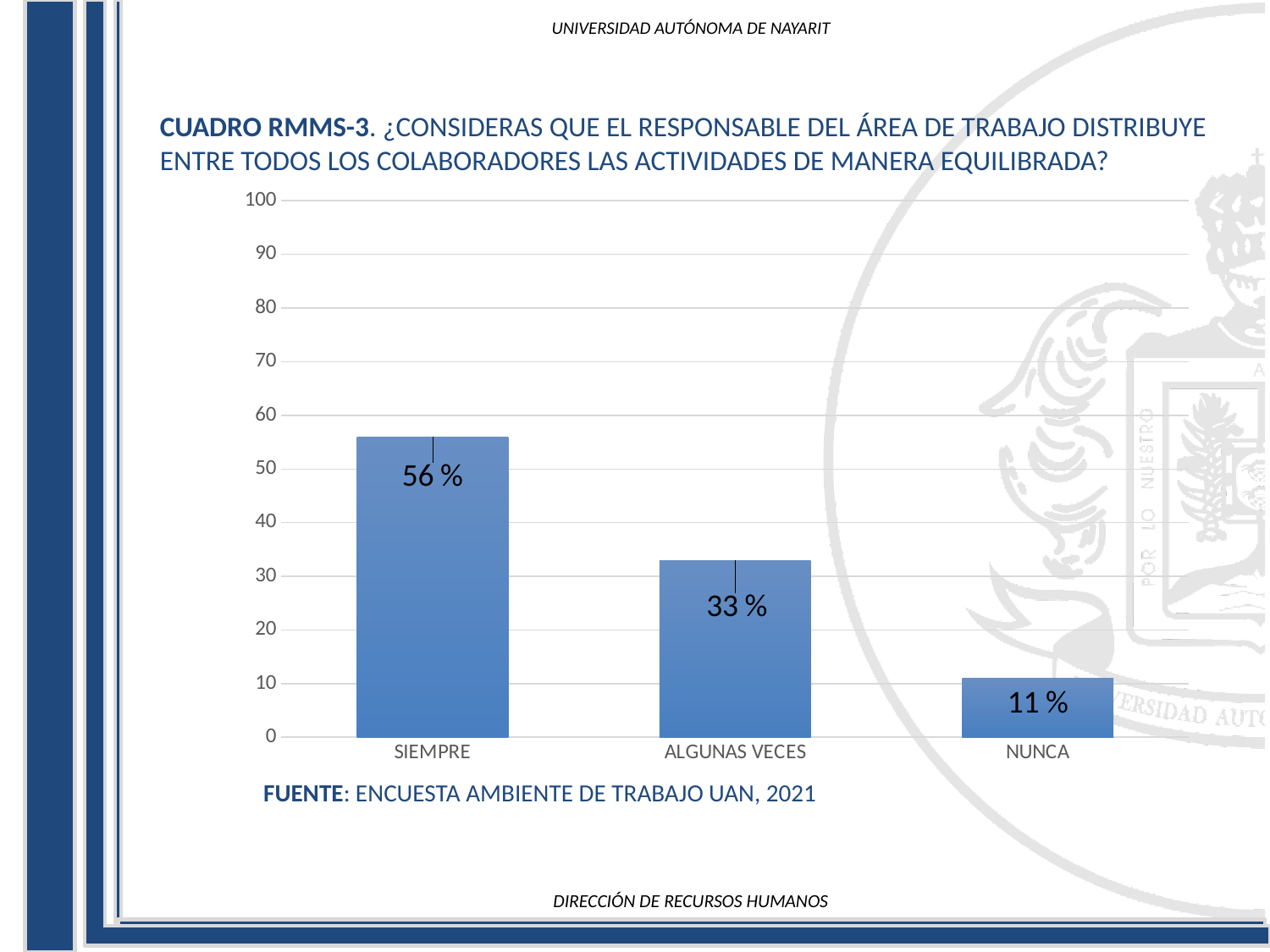
Which category has the highest value? SIEMPRE What is the value for ALGUNAS VECES? 33 % How many categories are shown on the x axis? 3 Which is larger, the value for ALGUNAS VECES or the value for NUNCA? ALGUNAS VECES What is the difference between the values for ALGUNAS VECES and NUNCA? 22 % What is the difference between the values for SIEMPRE and ALGUNAS VECES? 23 % Is the value for SIEMPRE greater or less than 50? greater What is the value for SIEMPRE? 56 % What kind of chart is shown on the slide? bar chart Do the values rise or fall from left to right along the x axis? fall What is the value for NUNCA? 11 % Which category has the lowest value? NUNCA